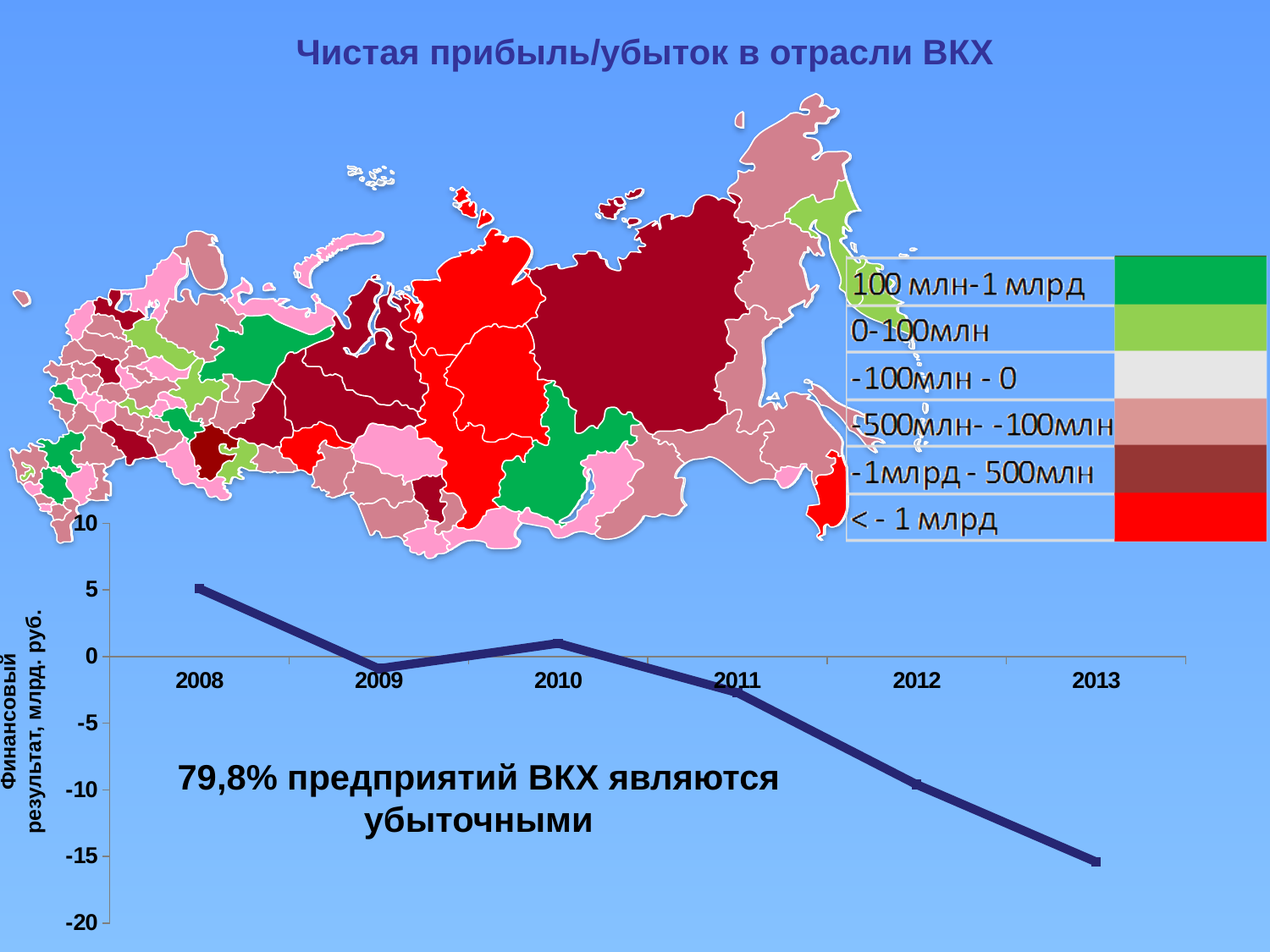
How many years are plotted on the line chart's x axis? 6 Does the line chart's value generally rise or fall from 2008 to 2013? fall On the line chart, is the value for 2011 greater or less than 0? less On the line chart, is the value for 2008 greater or less than 0? greater What kind of chart shows the financial result by year at the bottom of the slide? line chart On the line chart, is the value for 2012 greater or less than -5? less Which year has the highest value on the line chart? 2008 What is the title at the top of the slide? Чистая прибыль/убыток в отрасли ВКХ On the line chart, which year has the larger value, 2011 or 2012? 2011 Which year has the lowest value on the line chart? 2013 What is the label of the vertical axis of the line chart? Финансовый результат, млрд. руб.